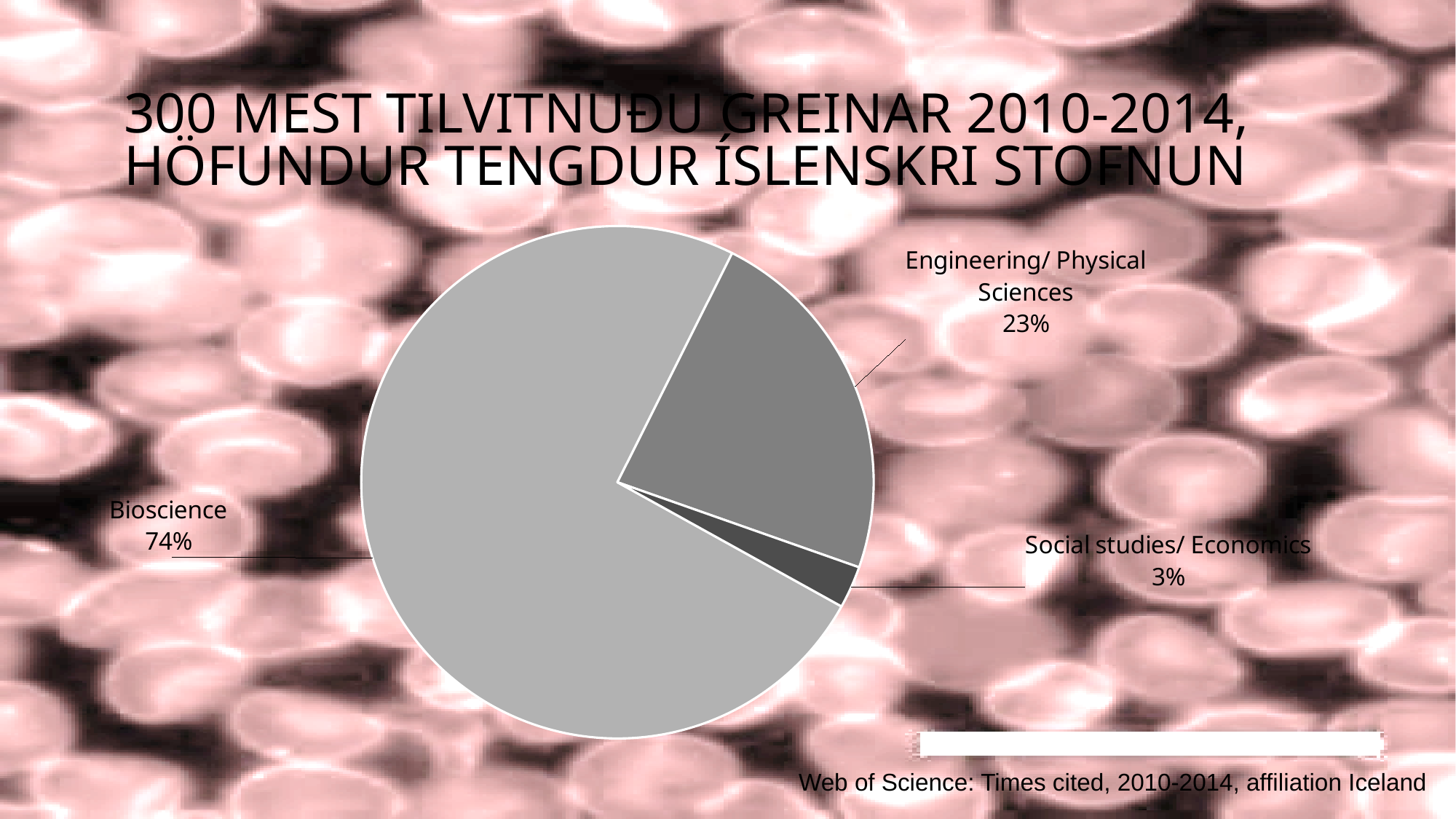
Which category has the smallest slice of the pie? Social studies/ Economics What share of the pie does Social studies/ Economics have? 3% What share of the pie does Bioscience have? 74% How many slices does the pie chart have? 3 Which is larger, the share for Engineering/ Physical Sciences or the share for Social studies/ Economics? Engineering/ Physical Sciences What kind of chart is shown on the slide? pie chart Which category has the largest slice of the pie? Bioscience What share of the pie does Engineering/ Physical Sciences have? 23% What is the difference in percentage points between Bioscience and Engineering/ Physical Sciences? 51 What is the difference in percentage points between Engineering/ Physical Sciences and Social studies/ Economics? 20 Which slice of the pie is the darkest in colour? Social studies/ Economics What is the source cited at the bottom of the slide? Web of Science: Times cited, 2010-2014, affiliation Iceland